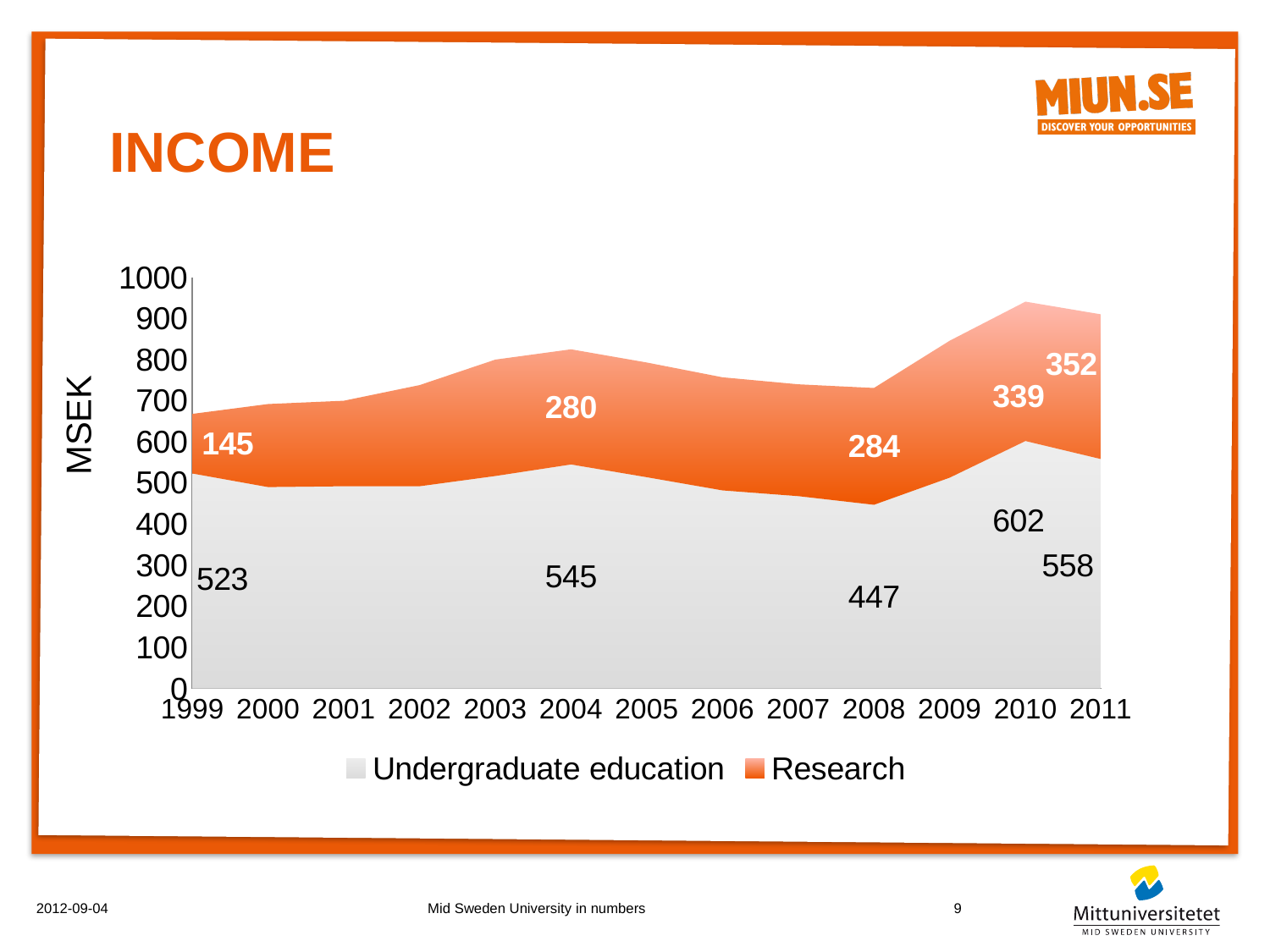
Which is larger, Undergraduate education in 2010 or in 2011? 2010 What is the Research value for 2011? 352 What is the total income (both series) for 2010? 941 What is the Undergraduate education value for 2010? 602 By how much did Research income increase from 1999 to 2011? 207 What is the Undergraduate education value for 1999? 523 What is the Research value for 2008? 284 What unit is shown on the y axis? MSEK How many series does the legend list? 2 What kind of chart is shown on the slide? Stacked area chart How many years are shown on the x axis? 13 Is the total income for 2003 greater or less than 700? greater